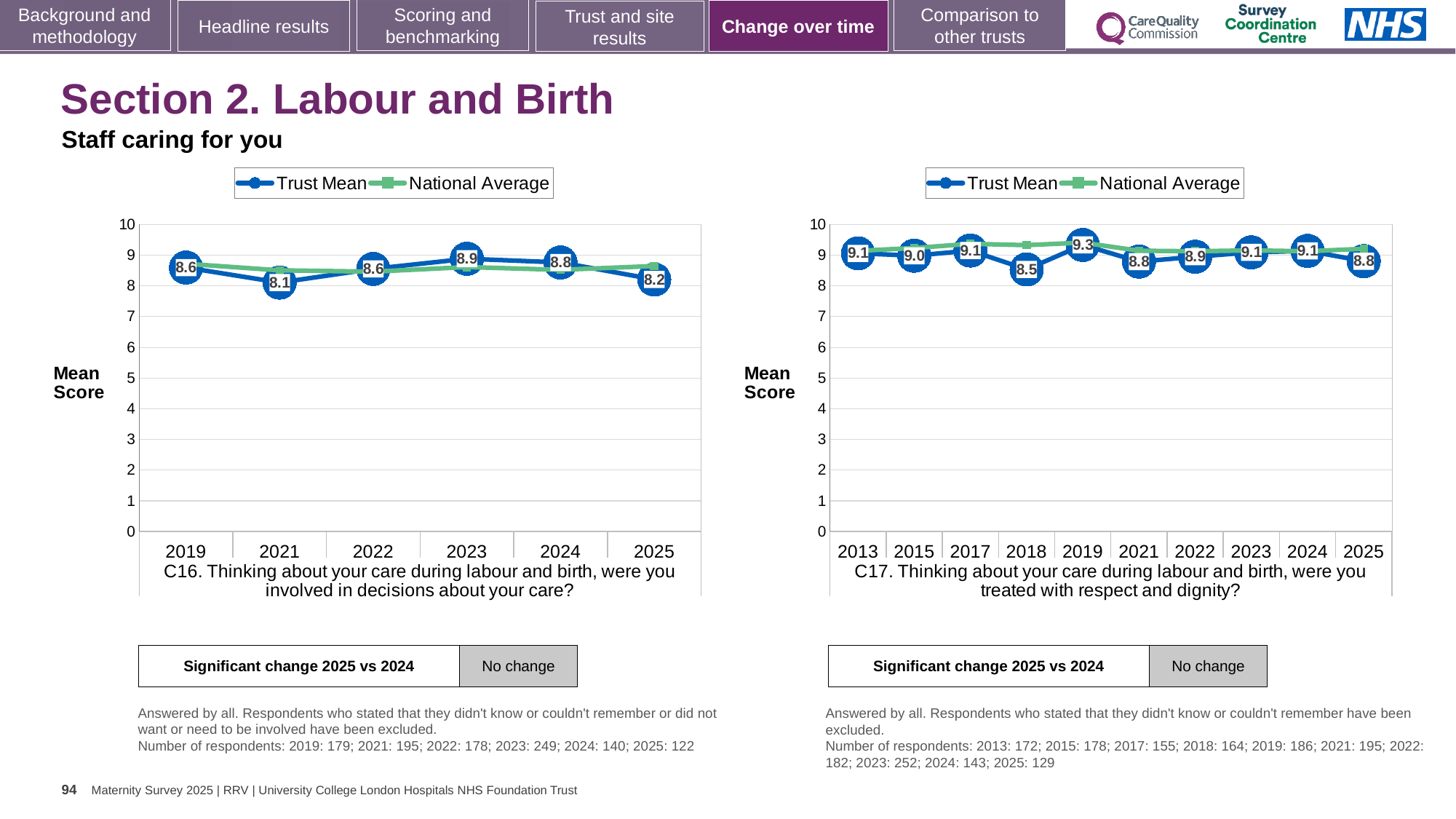
In the C16 chart (left), what is the Trust Mean for 2023? 8.9 How many series does the legend of the C17 chart (right) list? 2 In the C16 chart (left), what is the Trust Mean for 2025? 8.2 In the C17 chart (right), how many years are shown on the x axis? 10 In the C17 chart (right), which year has the highest Trust Mean? 2019 In the C16 chart (left), which year has the highest Trust Mean? 2023 In the C16 chart (left), which year has the lowest Trust Mean? 2021 In the C16 chart (left), what is the difference between the Trust Mean for 2023 and 2021? 0.8 In the C17 chart (right), what is the Trust Mean for 2018? 8.5 In the C17 chart (right), is the Trust Mean for 2024 larger or smaller than for 2025? larger In the C17 chart (right), which year has the lowest Trust Mean? 2018 In the C16 chart (left), how many years are shown on the x axis? 6